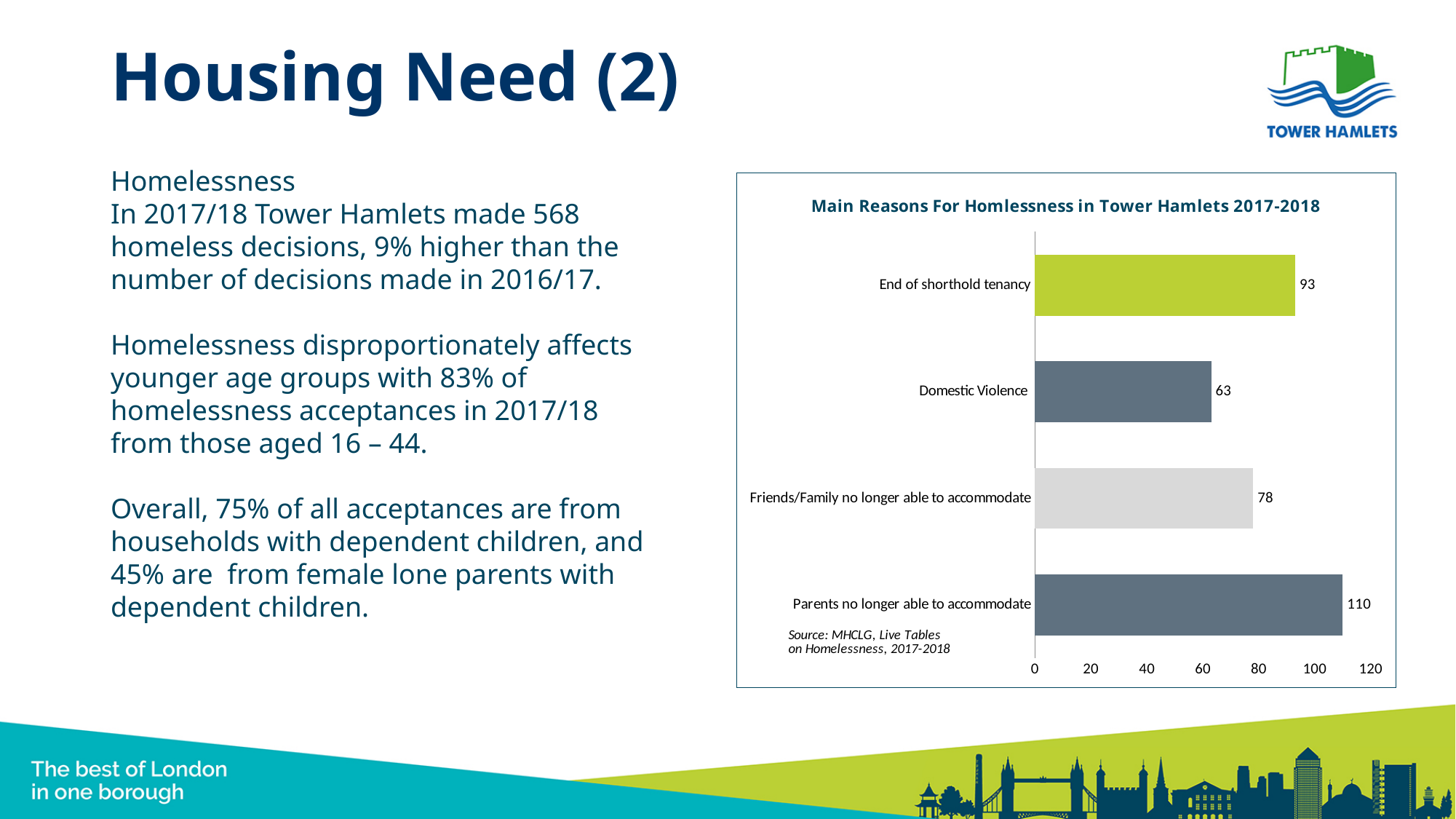
What is the value for End of shorthold tenancy? 93 Which is larger, the value for Friends/Family no longer able to accommodate or the value for Domestic Violence? Friends/Family no longer able to accommodate What is the title of the chart? Main Reasons For Homlessness in Tower Hamlets 2017-2018 Which reason has the lowest value? Domestic Violence What is the difference between the values for Parents no longer able to accommodate and End of shorthold tenancy? 17 Which reason has the highest value? Parents no longer able to accommodate What is the value for Domestic Violence? 63 What kind of chart is shown on the slide? bar chart How many reasons are shown in the chart? 4 What is the value for Friends/Family no longer able to accommodate? 78 Is the value for End of shorthold tenancy greater or less than 100? less What is the value for Parents no longer able to accommodate? 110